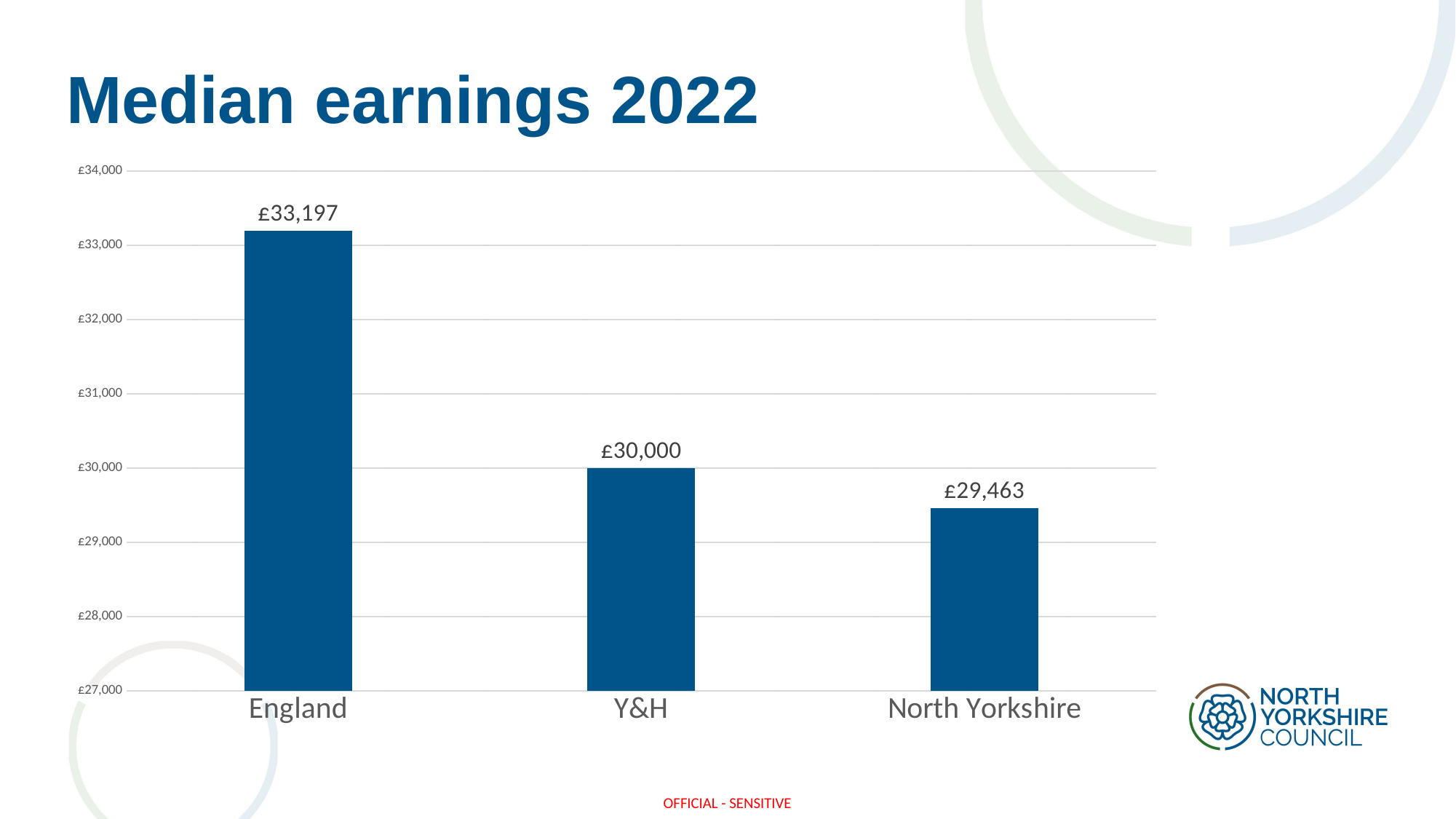
What is the difference between the median earnings for England and North Yorkshire? £3,734 What is the median earnings value for North Yorkshire? £29,463 What is the median earnings value for England? £33,197 How many categories are shown in the chart? 3 Which category has the lowest median earnings? North Yorkshire What is the difference between the median earnings for Y&H and North Yorkshire? £537 Which category has the highest median earnings? England Is the value for England greater or less than £33,000? greater Which has higher median earnings, Y&H or North Yorkshire? Y&H What kind of chart is shown on the slide? Bar chart What is the title of the slide? Median earnings 2022 What is the median earnings value for Y&H? £30,000